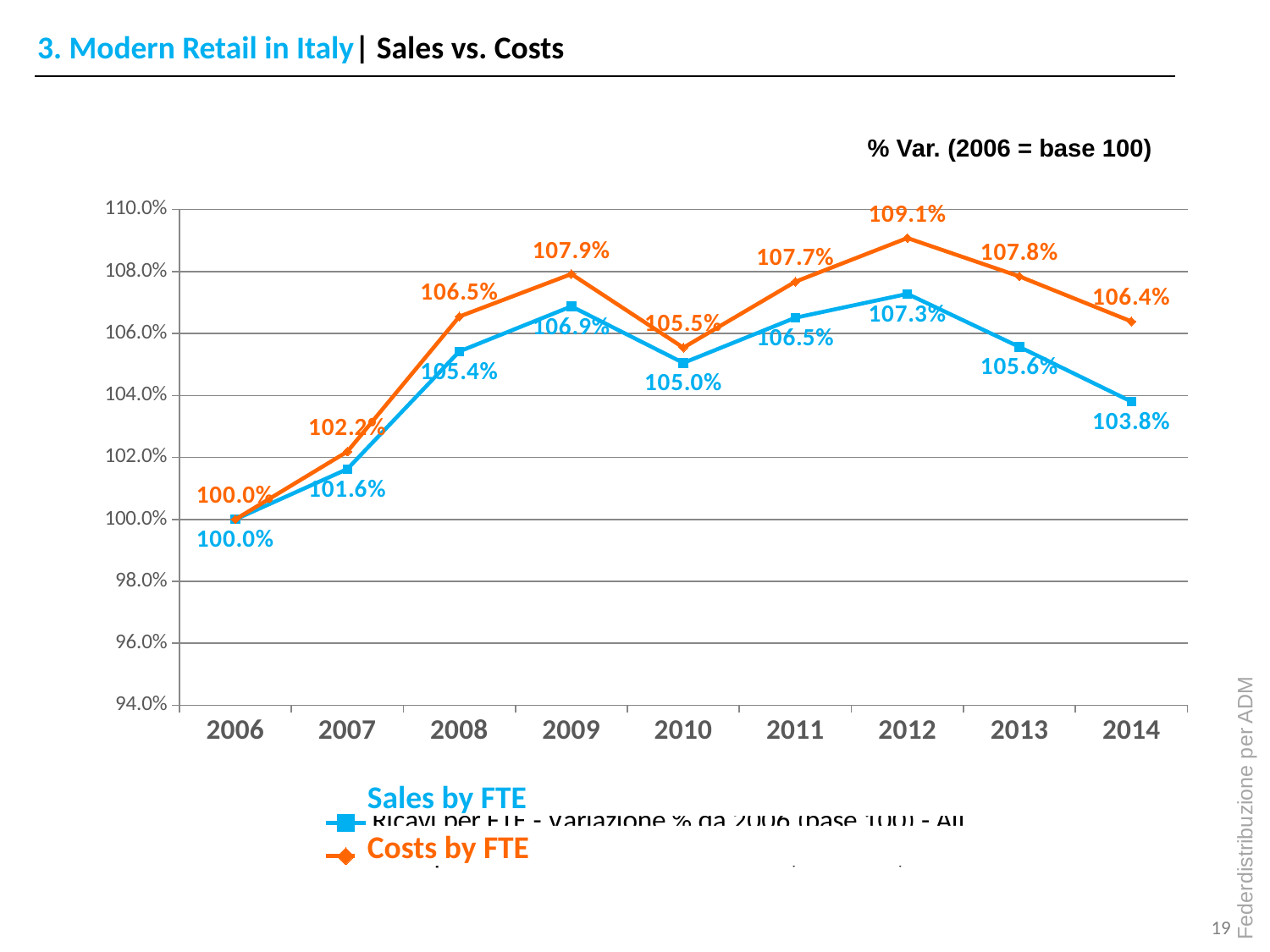
In which year is Sales by FTE at its lowest value? 2006 What type of chart is shown on the slide? Line chart How many series does the legend list? 2 What is the difference between Costs by FTE and Sales by FTE in 2014? 2.6% What is the value of Sales by FTE in 2009? 106.9% Which is larger in 2013, Costs by FTE or Sales by FTE? Costs by FTE What colour is the Costs by FTE line? Orange Does Sales by FTE rise or fall from 2012 to 2014? Fall How many years are plotted on the x axis? 9 What is the value of Costs by FTE in 2012? 109.1% What is the value of Sales by FTE in 2014? 103.8% In which year does Costs by FTE reach its highest value? 2012